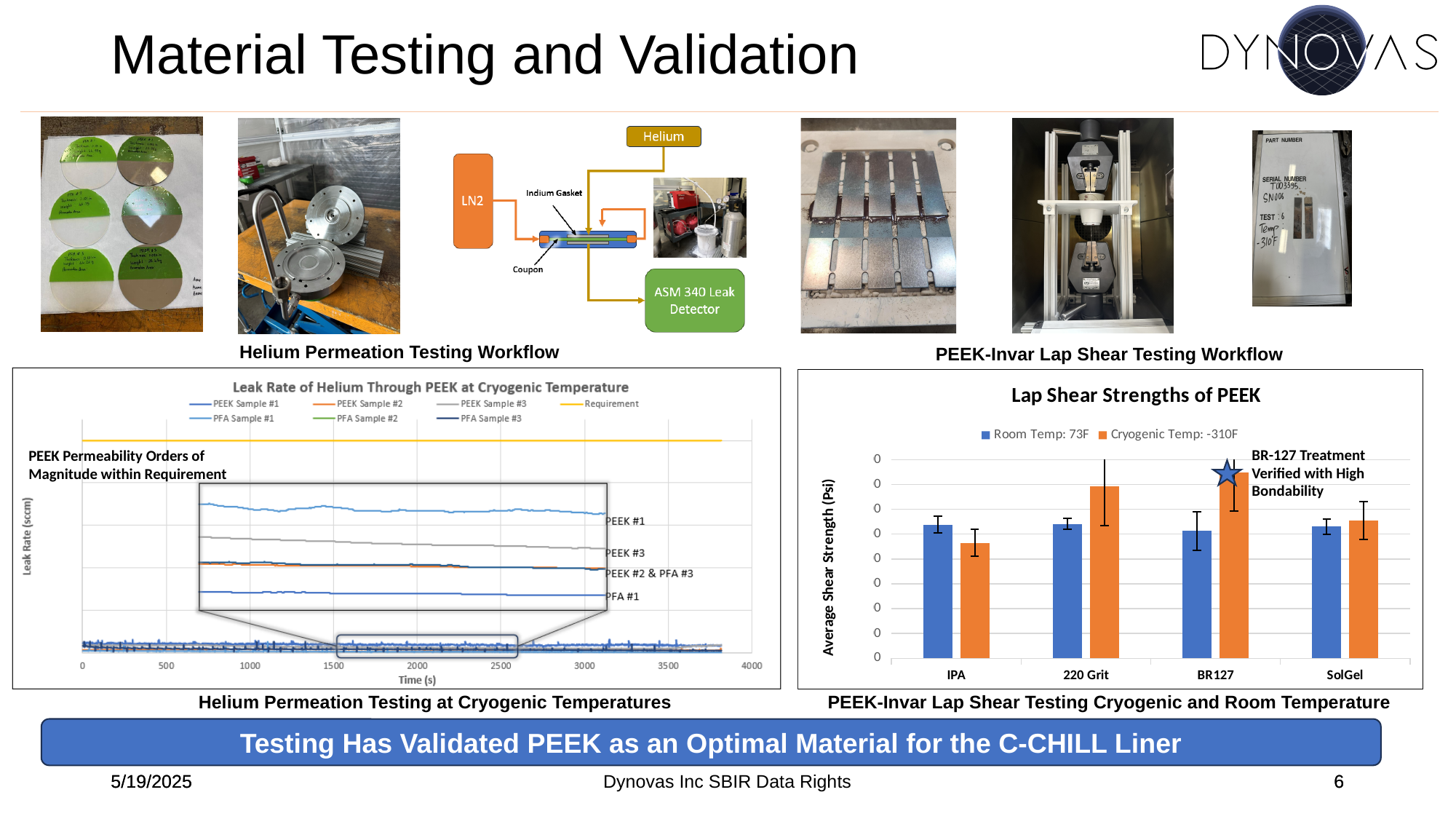
In the 'Lap Shear Strengths of PEEK' chart, for IPA, which is larger: the Room Temp: 73F bar or the Cryogenic Temp: -310F bar? Room Temp: 73F In the 'Lap Shear Strengths of PEEK' chart, what colour are the Cryogenic Temp: -310F bars? orange What is the x-axis label of the 'Leak Rate of Helium Through PEEK at Cryogenic Temperature' chart? Time (s) In the 'Lap Shear Strengths of PEEK' chart, for BR127, which is larger: the Room Temp: 73F bar or the Cryogenic Temp: -310F bar? Cryogenic Temp: -310F In the 'Lap Shear Strengths of PEEK' chart, which category has the lowest Cryogenic Temp: -310F bar? IPA How many series does the legend of the 'Lap Shear Strengths of PEEK' chart list? 2 In the 'Lap Shear Strengths of PEEK' chart, for 220 Grit, which is larger: the Room Temp: 73F bar or the Cryogenic Temp: -310F bar? Cryogenic Temp: -310F In the 'Lap Shear Strengths of PEEK' chart, which category has the highest Cryogenic Temp: -310F bar? BR127 How many series does the legend of the 'Leak Rate of Helium Through PEEK at Cryogenic Temperature' chart list? 7 What kind of chart is the 'Lap Shear Strengths of PEEK' chart? bar chart What kind of chart is the 'Leak Rate of Helium Through PEEK at Cryogenic Temperature' chart? line chart How many surface treatment categories are shown on the x axis of the 'Lap Shear Strengths of PEEK' chart? 4